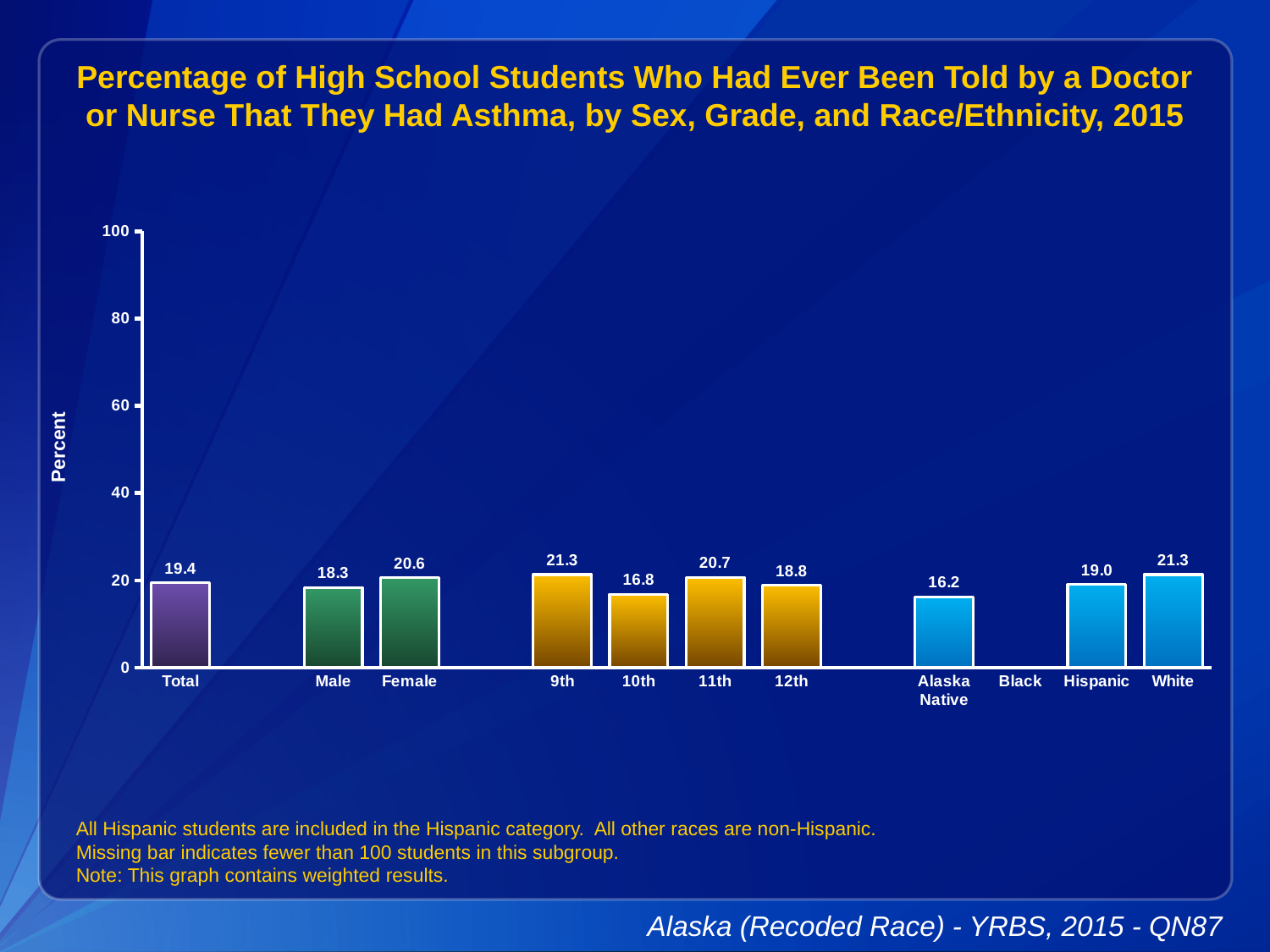
What is the value for 10th grade? 16.8 What kind of chart is shown on the slide? bar chart Which grade has the highest value? 9th How many bars are plotted on the chart? 10 Which race/ethnicity category has no bar shown? Black What is the value for Female? 20.6 Which is larger, the value for Hispanic or the value for White? White What is the value for Alaska Native? 16.2 What is the value for Total? 19.4 What is the difference between the Female and Male values? 2.3 Is the value for 11th grade greater or less than 40? less Which grade has the lowest value? 10th